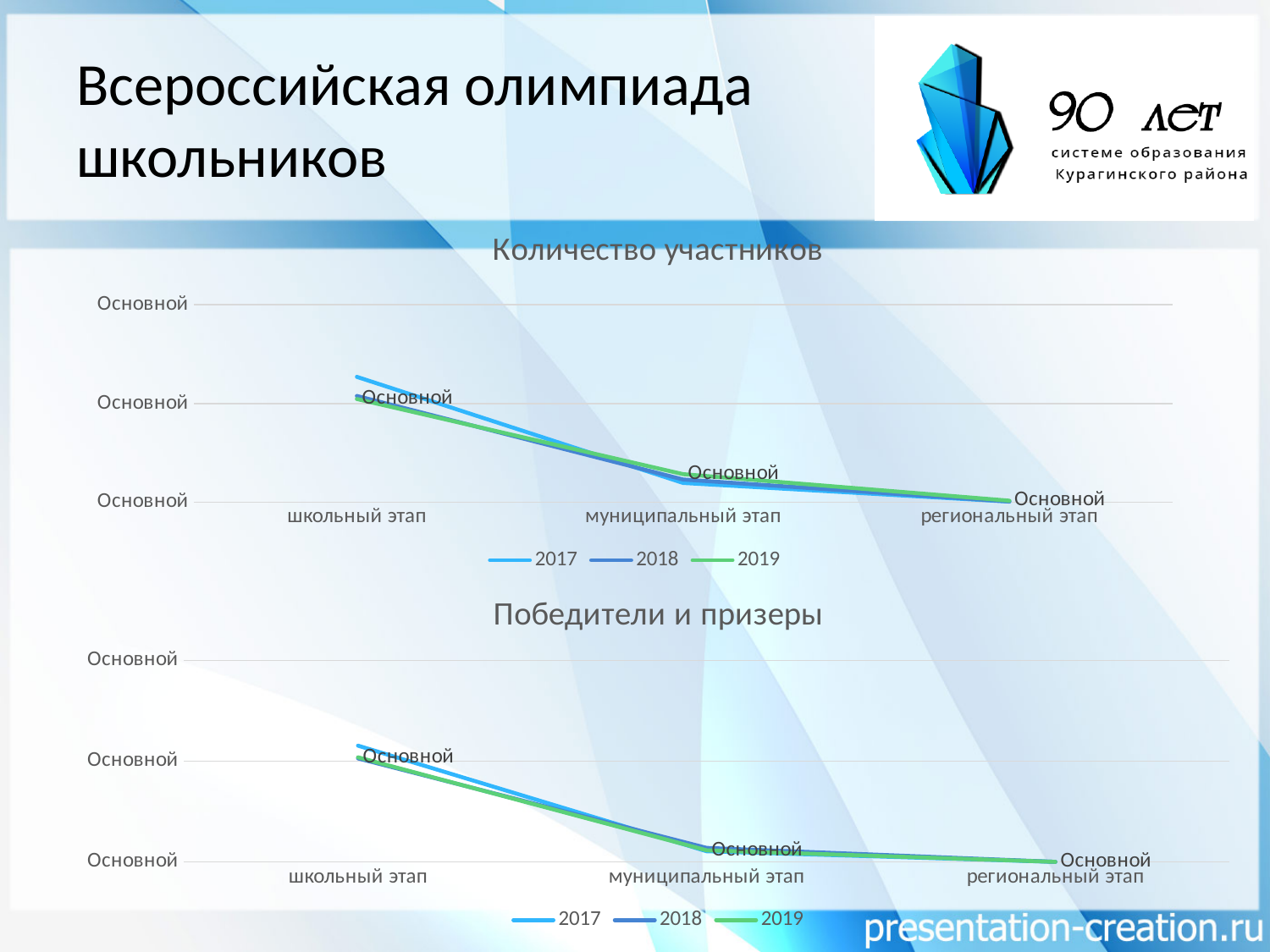
How many series does the legend of the "Количество участников" chart list? 3 Which years are listed in the legend of the "Победители и призеры" chart? 2017, 2018, 2019 In the "Победители и призеры" chart, do the values rise or fall along the x axis? fall In the "Количество участников" chart, for the 2018 series, which is larger: школьный этап or муниципальный этап? школьный этап In the "Количество участников" chart, do the values rise or fall from школьный этап to региональный этап? fall How many categories are shown on the x axis of the "Победители и призеры" chart? 3 In the "Победители и призеры" chart, which stage has the lowest value for the 2019 series? региональный этап What is the title of the top chart on the slide? Количество участников In the "Количество участников" chart, which stage has the highest number of participants for the 2017 series? школьный этап What kind of chart is the "Количество участников" chart? line chart In the "Количество участников" chart, at школьный этап, which series is larger: 2017 or 2019? 2017 What kind of chart is the "Победители и призеры" chart? line chart